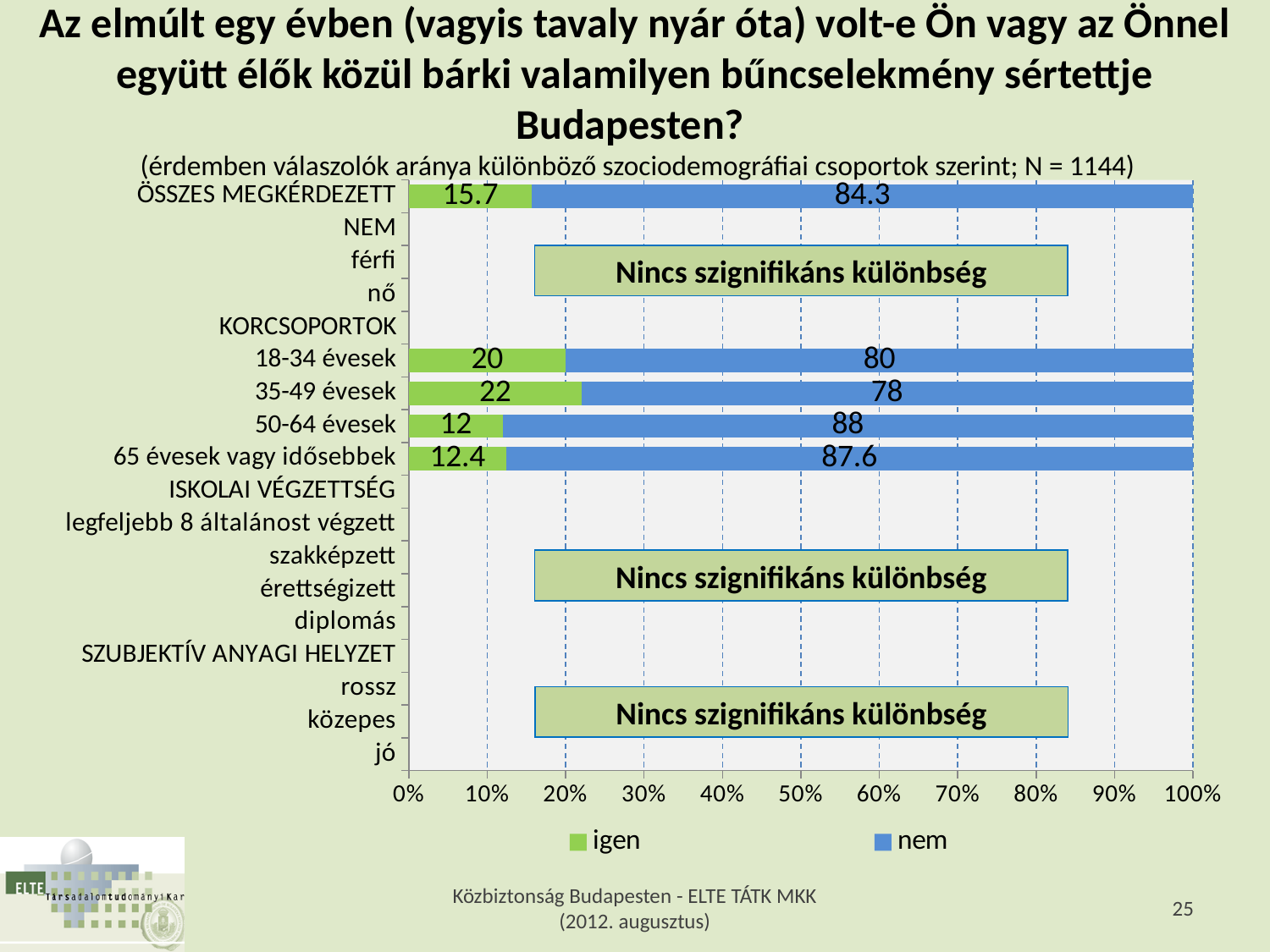
Among the age groups with plotted bars, which has the highest "igen" value? 35-49 évesek How many series does the legend list? 2 What text is shown in the boxes covering the NEM, ISKOLAI VÉGZETTSÉG and SZUBJEKTÍV ANYAGI HELYZET groups? Nincs szignifikáns különbség Among the age groups with plotted bars, which has the lowest "igen" value? 50-64 évesek What is the "igen" value for ÖSSZES MEGKÉRDEZETT? 15.7 Is the "nem" value for 50-64 évesek greater or less than 80%? greater What is the "igen" value for 65 évesek vagy idősebbek? 12.4 What is the total of the stacked bar for 18-34 évesek? 100 Which has a larger "igen" value, 18-34 évesek or 65 évesek vagy idősebbek? 18-34 évesek What is the difference between the "nem" values for 50-64 évesek and 18-34 évesek? 8 What is the "nem" value for 35-49 évesek? 78 What kind of chart is shown on the slide? Stacked bar chart